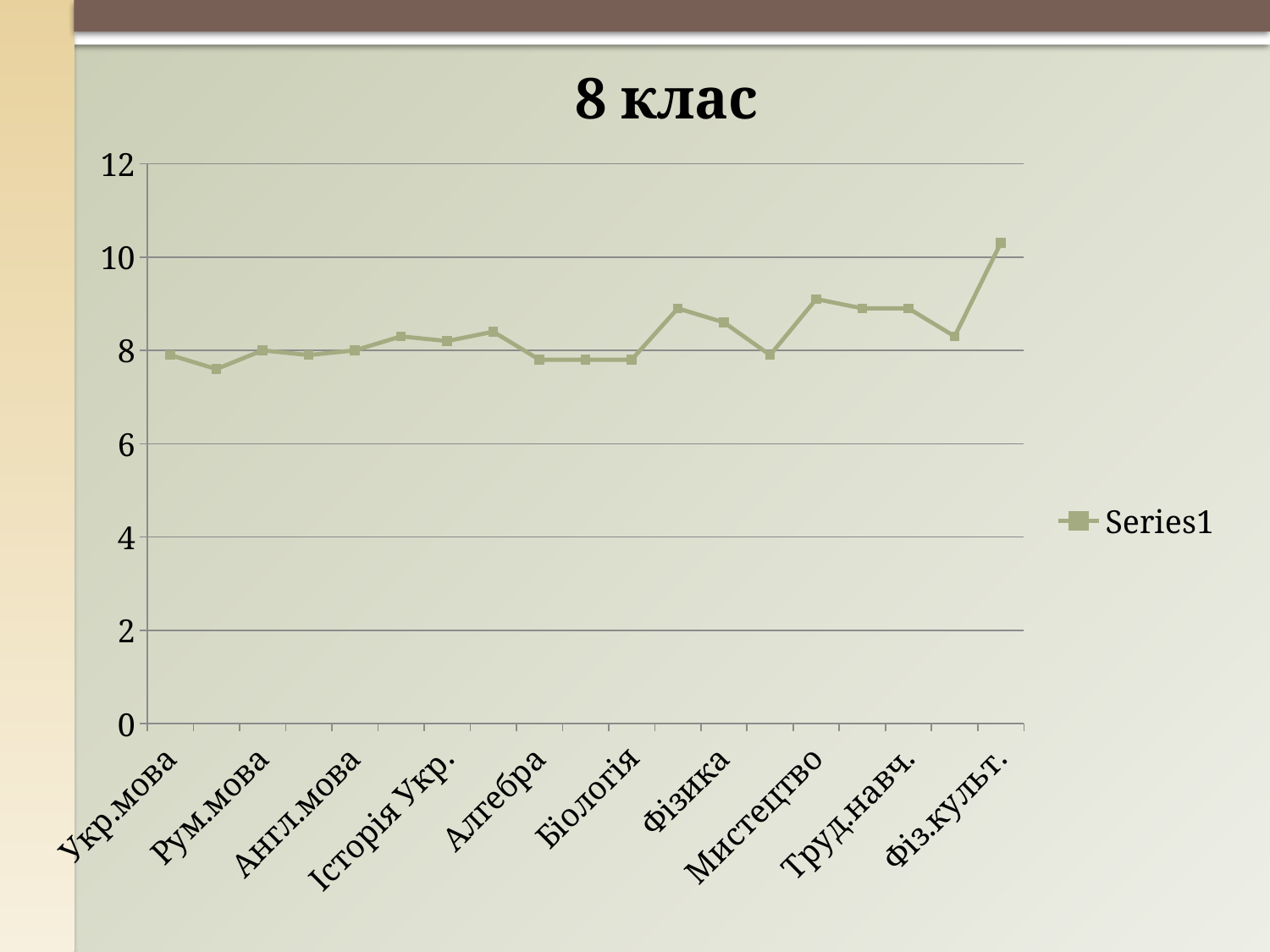
Is the value for Фіз.культ. greater or less than 10? greater What type of chart is shown on the slide? line chart Is the value for Фізика greater or less than 8? greater How many data points are plotted on the line? 19 How many series does the legend list? 1 What is the name of the series shown in the legend? Series1 Which has the larger value, Мистецтво or Біологія? Мистецтво Is the value for Мистецтво greater or less than 8? greater What is the title of the chart? 8 клас Which labelled subject has the highest value on the chart? Фіз.культ. Which has the larger value, Фіз.культ. or Укр.мова? Фіз.культ.